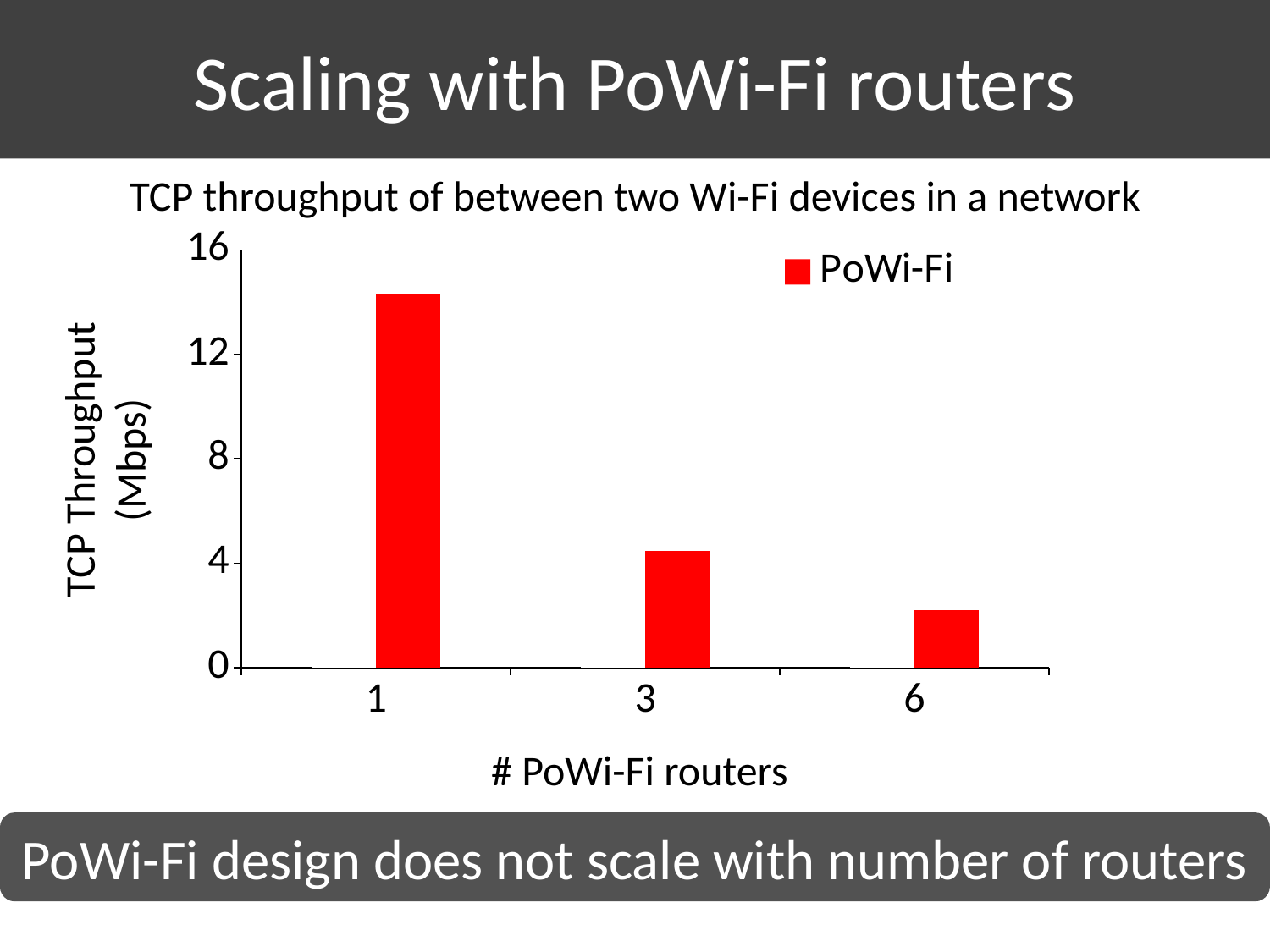
Which has a higher TCP throughput: 3 PoWi-Fi routers or 6 PoWi-Fi routers? 3 Is the TCP throughput for 1 PoWi-Fi router greater or less than 12 Mbps? greater Is the TCP throughput for 6 PoWi-Fi routers greater or less than 4 Mbps? less How many series does the legend list? 1 Does TCP throughput rise or fall as the number of PoWi-Fi routers increases? fall What is the title of the chart? TCP throughput of between two Wi-Fi devices in a network How many bars (categories) are plotted in the chart? 3 Which number of PoWi-Fi routers has the lowest TCP throughput? 6 What is the label of the y axis? TCP Throughput (Mbps) Is the TCP throughput for 3 PoWi-Fi routers greater or less than 8 Mbps? less Which number of PoWi-Fi routers has the highest TCP throughput? 1 What kind of chart is shown on the slide? bar chart